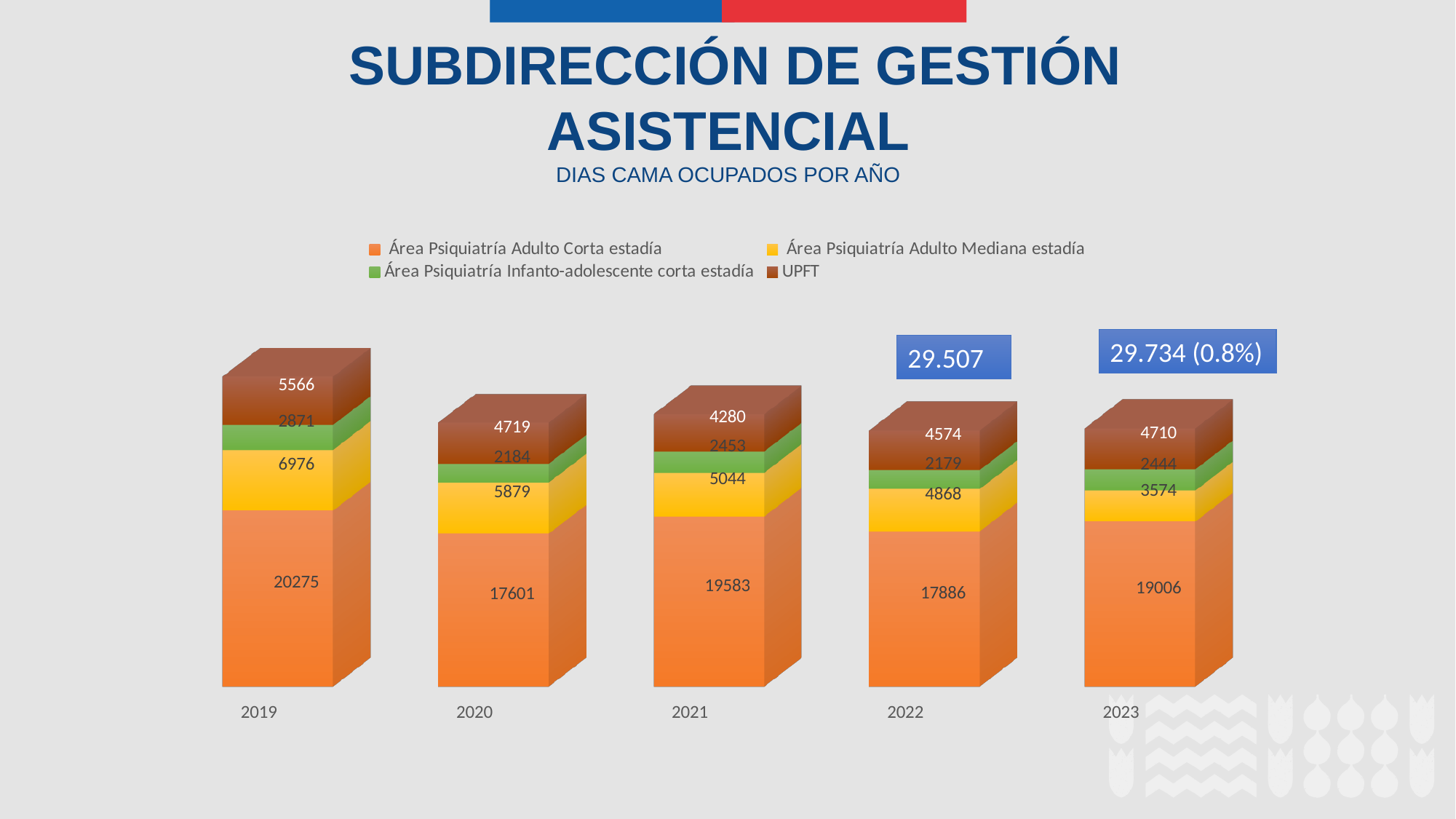
What is the value for Área Psiquiatría Adulto Corta estadía in 2019? 20275 How many years are shown on the x axis? 5 What type of chart is shown on the slide? bar chart How many series does the legend list? 4 What is the total of the stacked bar for 2020? 30383 In which year is the Área Psiquiatría Adulto Mediana estadía value highest? 2019 What is the UPFT value in 2021? 4280 What total is shown in the label above the 2022 bar? 29.507 Which is larger, the Área Psiquiatría Infanto-adolescente corta estadía value in 2021 or in 2022? 2021 What is the difference between the UPFT values in 2019 and 2020? 847 What is the value for Área Psiquiatría Adulto Mediana estadía in 2023? 3574 In which year is the Área Psiquiatría Adulto Corta estadía value lowest? 2020